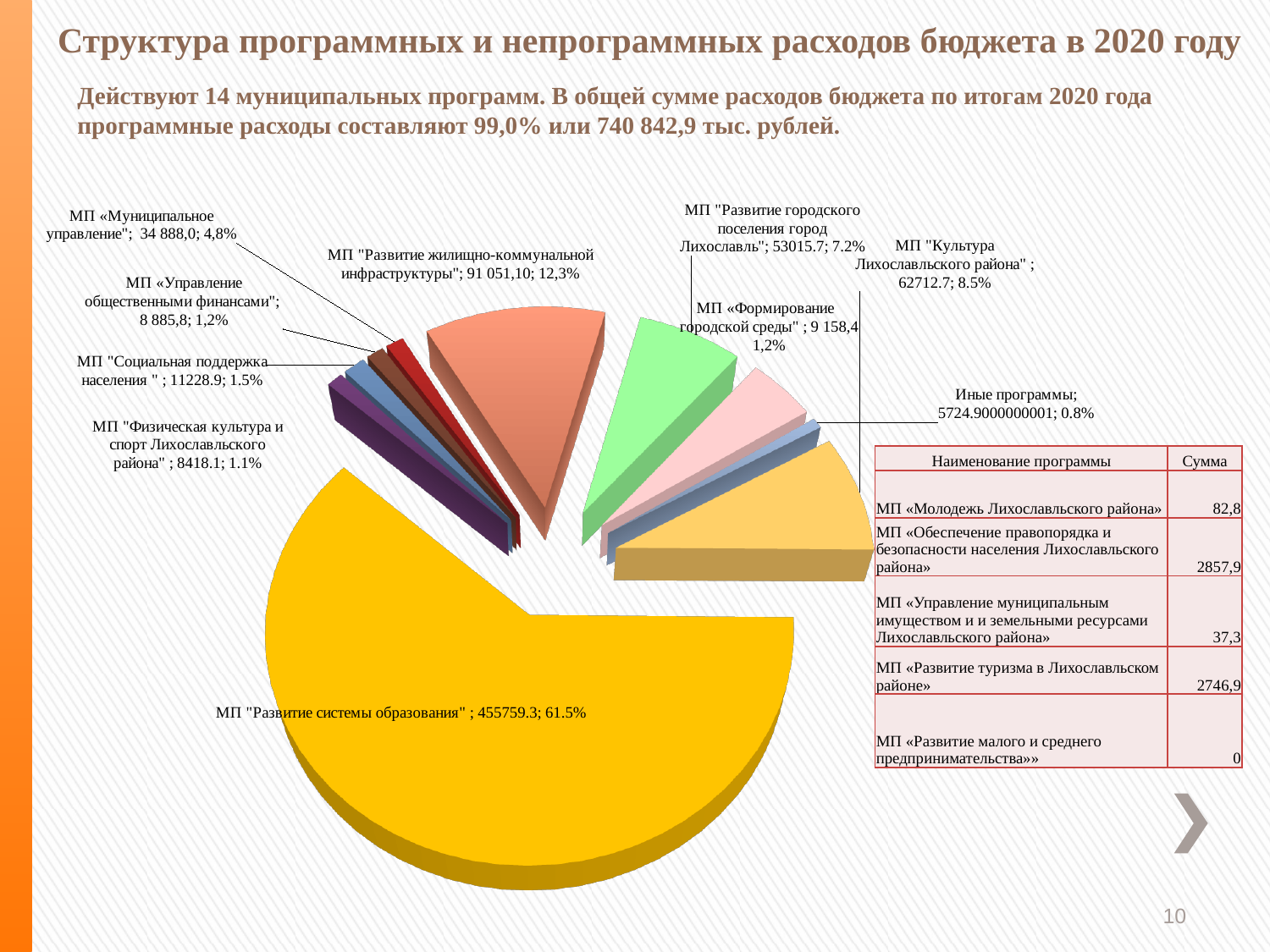
What is the value shown for МП "Развитие жилищно-коммунальной инфраструктуры"? 91 051,10 What kind of chart is shown on the slide? Pie chart Which is larger: the share for МП "Развитие городского поселения город Лихославль" or for МП "Культура Лихославльского района"? МП "Культура Лихославльского района" What is the value shown for МП «Муниципальное управление»? 34 888,0 Which slice has the smallest share of the pie chart? Иные программы What percentage is shown for Иные программы? 0.8% What is the value shown for МП "Социальная поддержка населения"? 11228.9 What percentage is shown for МП «Формирование городской среды»? 1,2% How many slices are labelled in the pie chart? 10 What percentage is shown for МП "Культура Лихославльского района"? 8.5% Which program has the largest slice of the pie chart? МП "Развитие системы образования" What share of the pie does МП "Развитие системы образования" account for? 61.5%